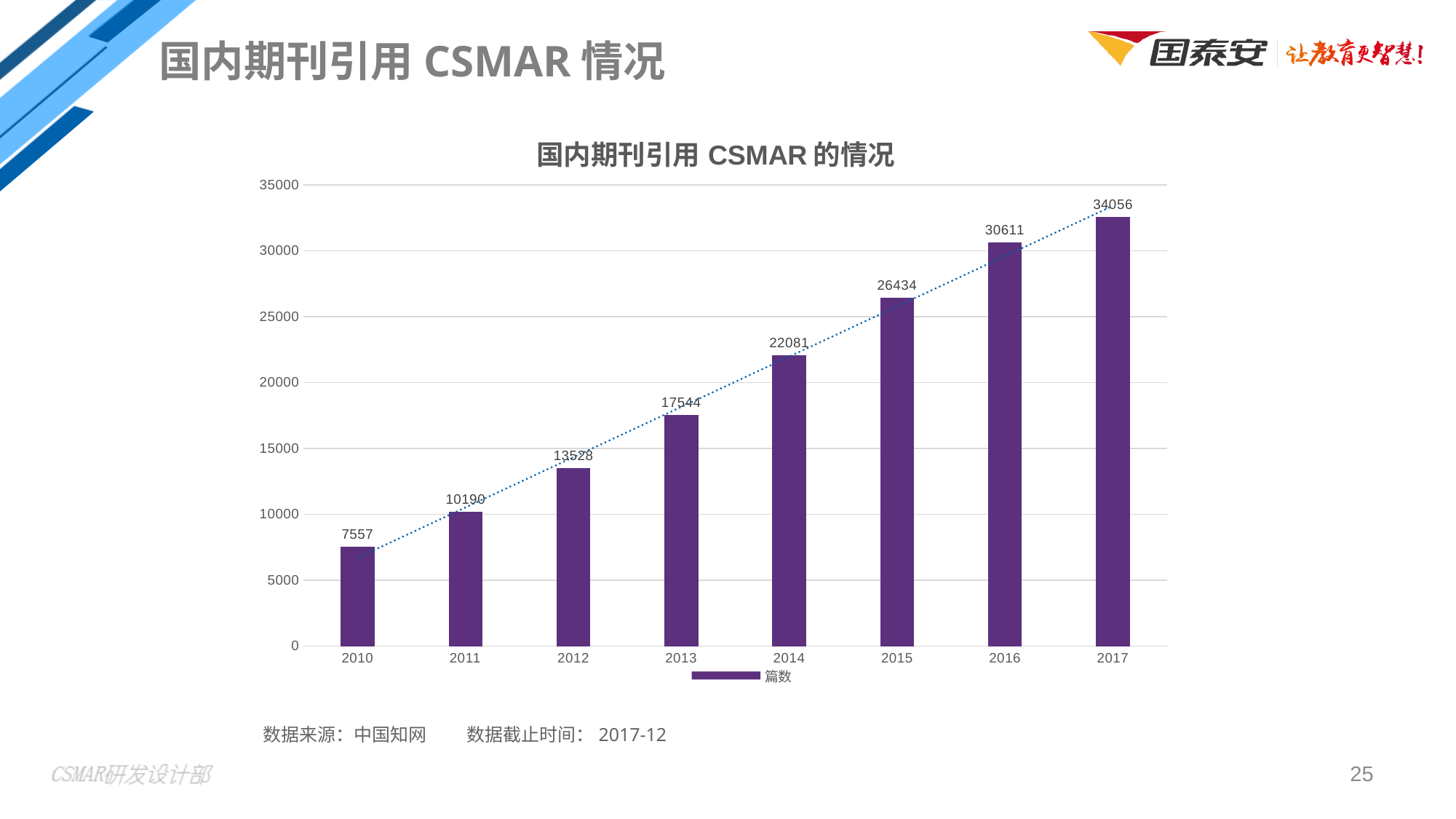
Which is larger, the value for 2015 or the value for 2013? 2015 Which year has the lowest value? 2010 What is the value for 2010? 7557 What is the difference between the values for 2017 and 2016? 3445 What is the value for 2014? 22081 What is the value for 2016? 30611 Which year has the highest value? 2017 What is the difference between the values for 2013 and 2012? 4016 Is the value for 2012 greater or less than 15000? less What kind of chart is this? bar chart How many years are shown on the x axis? 8 Do the values rise or fall from 2010 to 2017? rise